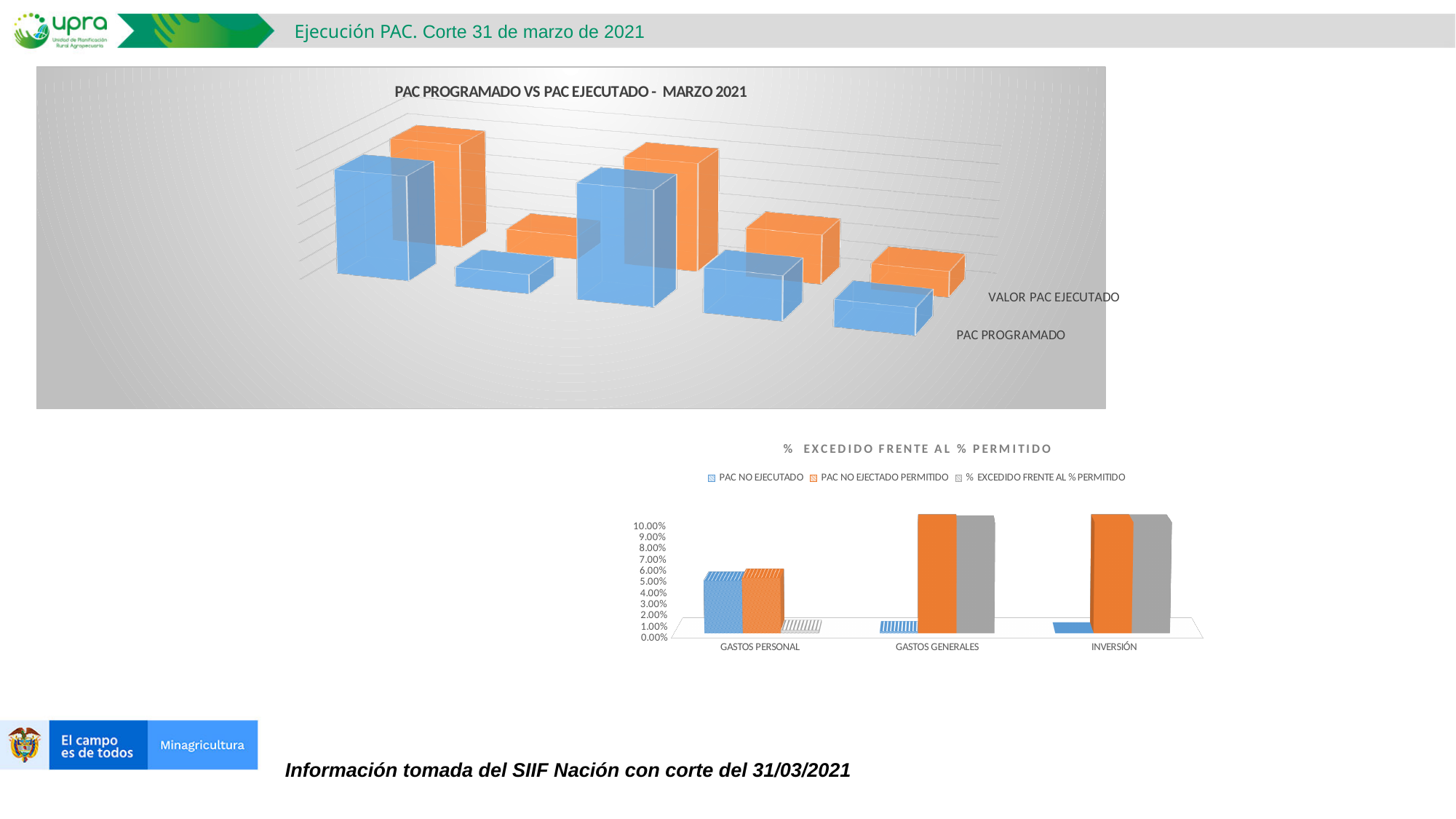
In the bottom chart '% EXCEDIDO FRENTE AL % PERMITIDO', how many categories are shown on the x axis? 3 In the bottom chart '% EXCEDIDO FRENTE AL % PERMITIDO', is the PAC NO EJECUTADO value for GASTOS GENERALES greater or less than 3.00%? less In the bottom chart '% EXCEDIDO FRENTE AL % PERMITIDO', is the PAC NO EJECUTADO value for GASTOS PERSONAL greater or less than 3.00%? greater In the bottom chart '% EXCEDIDO FRENTE AL % PERMITIDO', which category has the lowest PAC NO EJECTADO PERMITIDO value? GASTOS PERSONAL In the bottom chart '% EXCEDIDO FRENTE AL % PERMITIDO', which category has the highest PAC NO EJECUTADO value? GASTOS PERSONAL In the bottom chart '% EXCEDIDO FRENTE AL % PERMITIDO', is the PAC NO EJECTADO PERMITIDO value for GASTOS PERSONAL greater or less than 8.00%? less What kind of chart is the bottom chart titled '% EXCEDIDO FRENTE AL % PERMITIDO'? Bar chart In the top chart 'PAC PROGRAMADO VS PAC EJECUTADO - MARZO 2021', which series is shown in orange? VALOR PAC EJECUTADO In the top chart 'PAC PROGRAMADO VS PAC EJECUTADO - MARZO 2021', how many series are plotted? 2 In the bottom chart '% EXCEDIDO FRENTE AL % PERMITIDO', how many series does the legend list? 3 In the bottom chart '% EXCEDIDO FRENTE AL % PERMITIDO', is the PAC NO EJECUTADO value larger for GASTOS PERSONAL or for INVERSIÓN? GASTOS PERSONAL